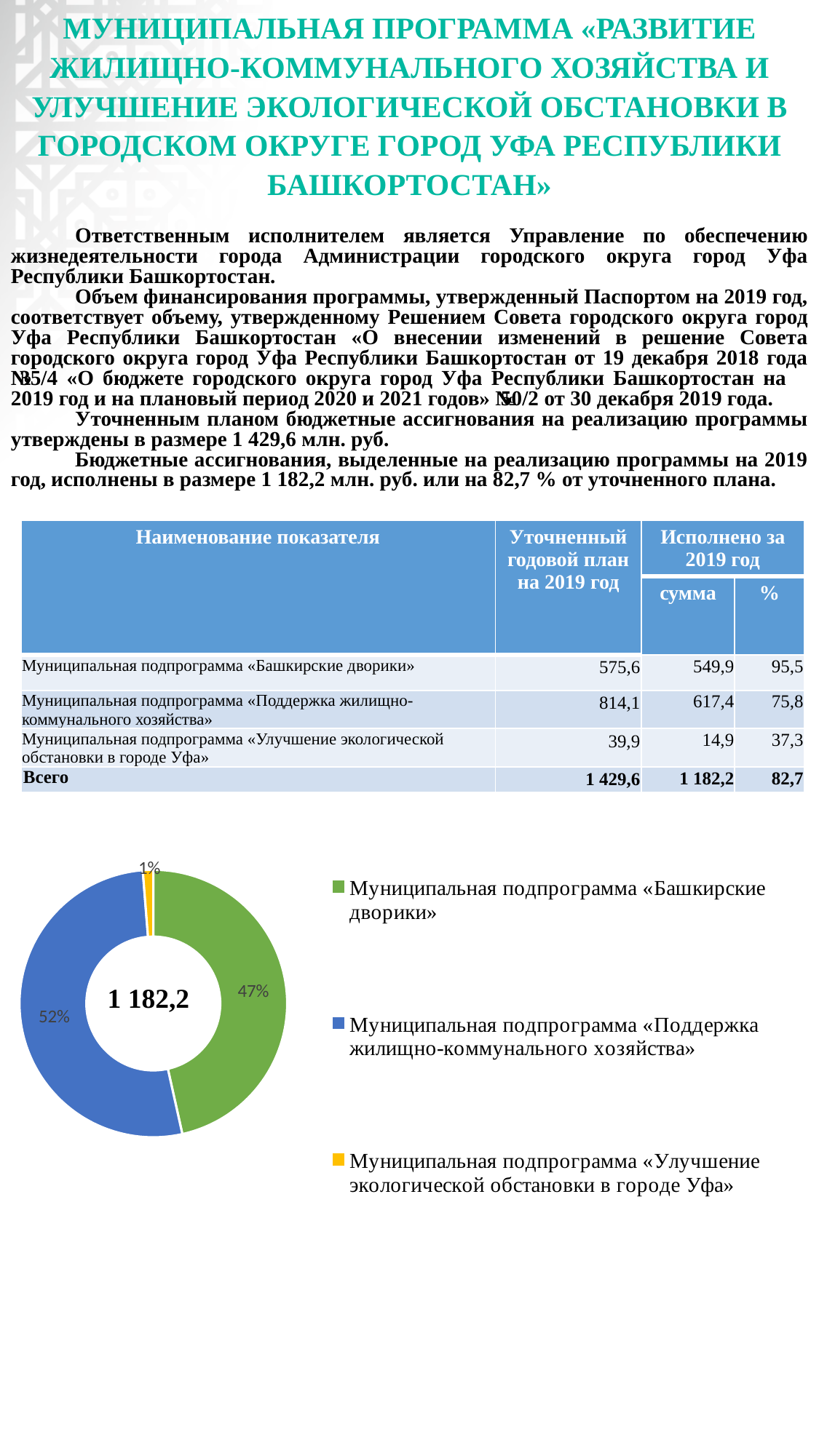
How many entries does the legend of the doughnut chart list? 3 What share of the doughnut chart does «Муниципальная подпрограмма «Поддержка жилищно-коммунального хозяйства»» take? 52% What share of the doughnut chart does «Муниципальная подпрограмма «Башкирские дворики»» take? 47% In the doughnut chart, which is larger: the share of «Башкирские дворики» or the share of «Поддержка жилищно-коммунального хозяйства»? Поддержка жилищно-коммунального хозяйства What value is printed in the centre of the doughnut chart? 1 182,2 Which slice of the doughnut chart is the largest? Муниципальная подпрограмма «Поддержка жилищно-коммунального хозяйства» What is the difference in percentage points between the «Поддержка жилищно-коммунального хозяйства» slice and the «Башкирские дворики» slice in the doughnut chart? 5 percentage points What share of the doughnut chart does «Муниципальная подпрограмма «Улучшение экологической обстановки в городе Уфа»» take? 1% Which slice of the doughnut chart is the smallest? Муниципальная подпрограмма «Улучшение экологической обстановки в городе Уфа» How many slices does the doughnut chart have? 3 What kind of chart is shown on the slide? Doughnut (pie) chart What colour is the slice for «Муниципальная подпрограмма «Улучшение экологической обстановки в городе Уфа»» in the doughnut chart? Yellow